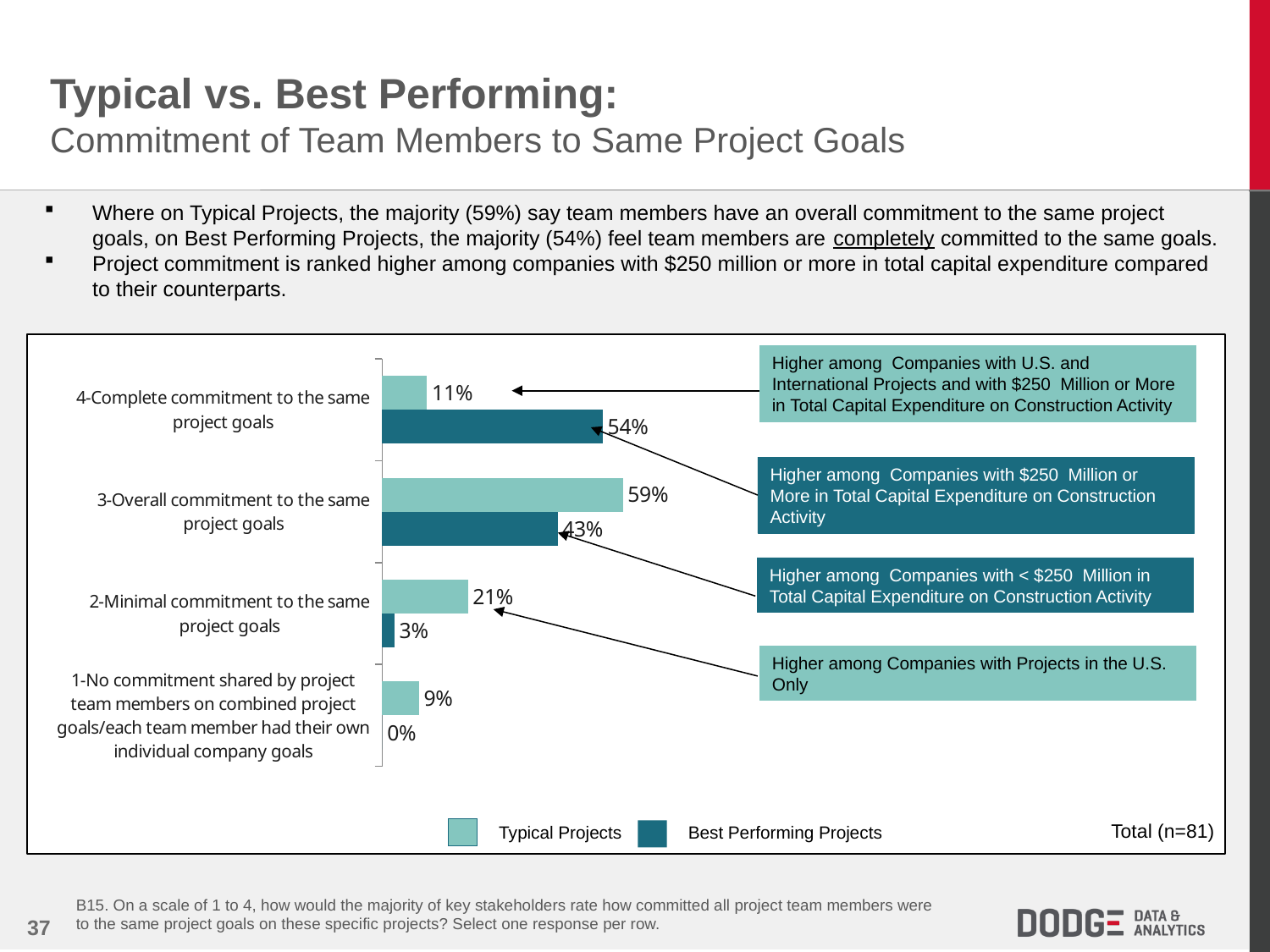
What percentage of Best Performing Projects have complete commitment to the same project goals? 54% What is the difference between Best Performing Projects and Typical Projects for complete commitment to the same project goals? 43% What is the total sample size shown on the chart? n=81 What is the value for Best Performing Projects for overall commitment to the same project goals? 43% What is the value for Typical Projects for minimal commitment to the same project goals? 21% For minimal commitment to the same project goals, which series has the larger value, Typical Projects or Best Performing Projects? Typical Projects Which category has the lowest value for Best Performing Projects? 1-No commitment shared by project team members on combined project goals/each team member had their own individual company goals What percentage of Typical Projects have complete commitment to the same project goals? 11% What kind of chart is shown on the slide? Bar chart Which category has the highest value for Typical Projects? 3-Overall commitment to the same project goals How many series does the legend list? 2 How many categories are shown on the chart? 4